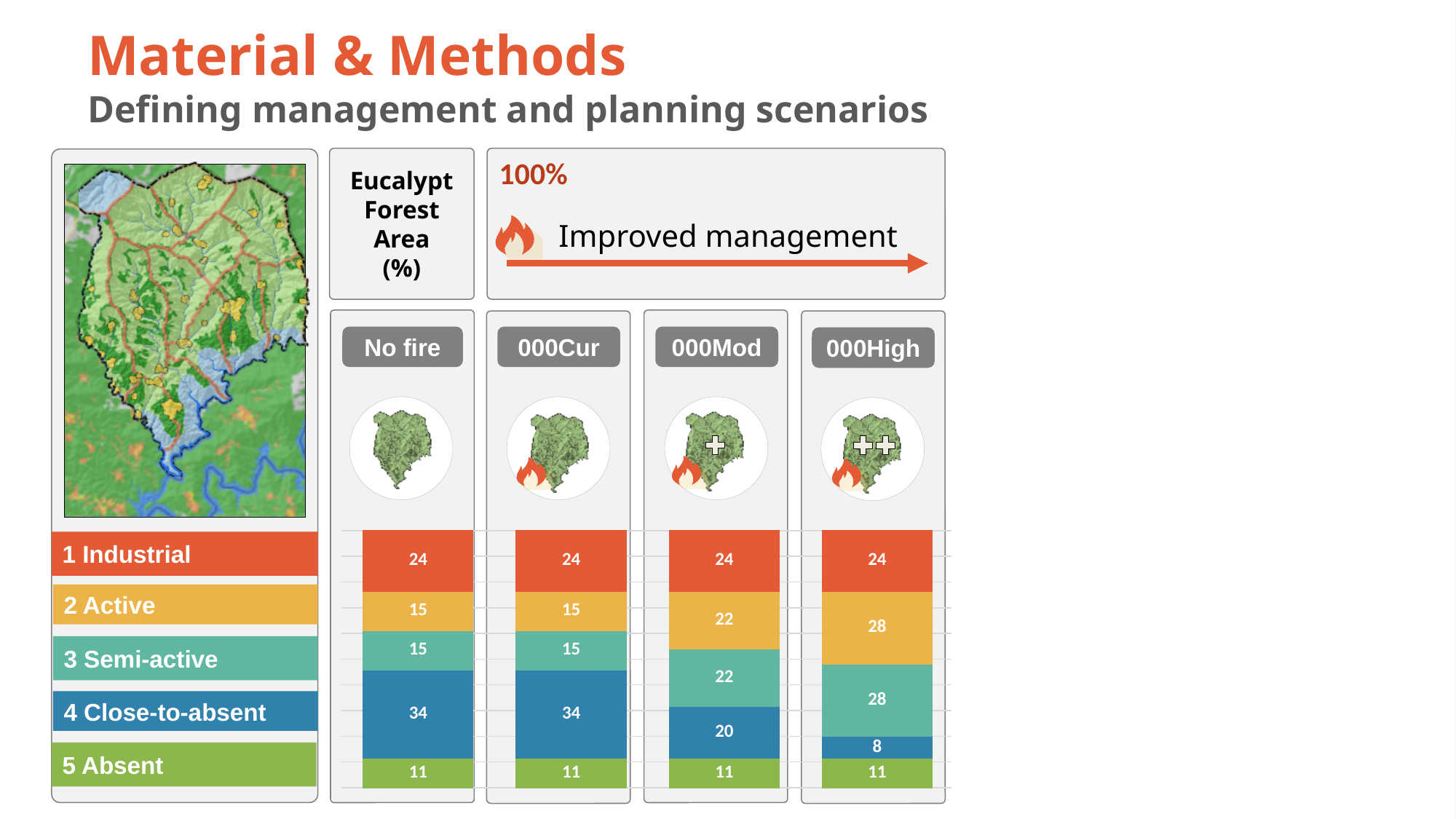
Which management category has the largest value in the 000High scenario? 2 Active and 3 Semi-active (28 each) How many scenario bars are shown? 4 What is the value for Active in the 000High scenario? 28 Which management category has the smallest value in the 000High scenario? 4 Close-to-absent Which is larger: the Active value in 000Mod or the Active value in 000High? 000High How many management categories are stacked in each bar? 5 What is the value for Close-to-absent in the No fire scenario? 34 What is the value for Industrial in the 000Cur scenario? 24 What is the difference between the Close-to-absent values in the 000Cur and 000High scenarios? 26 What is the value for Semi-active in the 000Mod scenario? 22 What kind of chart is used to show the eucalypt forest area by management category? Stacked bar chart Which management category has the smallest value in the No fire scenario? 5 Absent